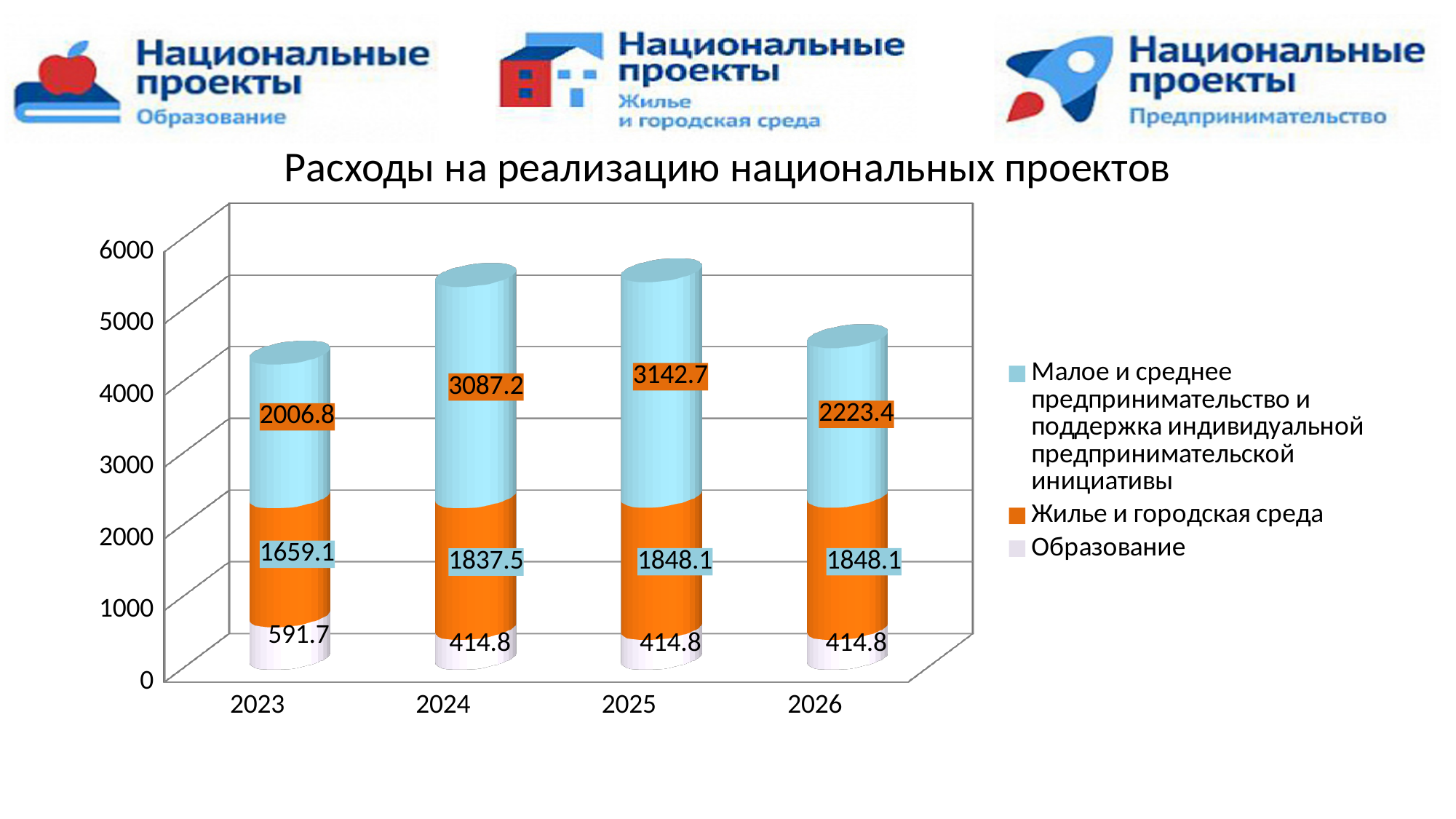
What is the value for Жилье и городская среда in 2024? 1837.5 What is the total of the stacked bar for 2023? 4257.6 What is the difference between the Малое и среднее предпринимательство values for 2024 and 2026? 863.8 What is the value for Образование in 2023? 591.7 In which year is the value for Малое и среднее предпринимательство и поддержка индивидуальной предпринимательской инициативы the highest? 2025 What is the value for Малое и среднее предпринимательство и поддержка индивидуальной предпринимательской инициативы in 2025? 3142.7 Which is larger: the Образование value in 2023 or in 2024? 2023 How many years are shown on the x axis? 4 How many series does the legend list? 3 What is the title of the chart? Расходы на реализацию национальных проектов What type of chart is shown on the slide? bar chart In which year is the value for Жилье и городская среда the lowest? 2023